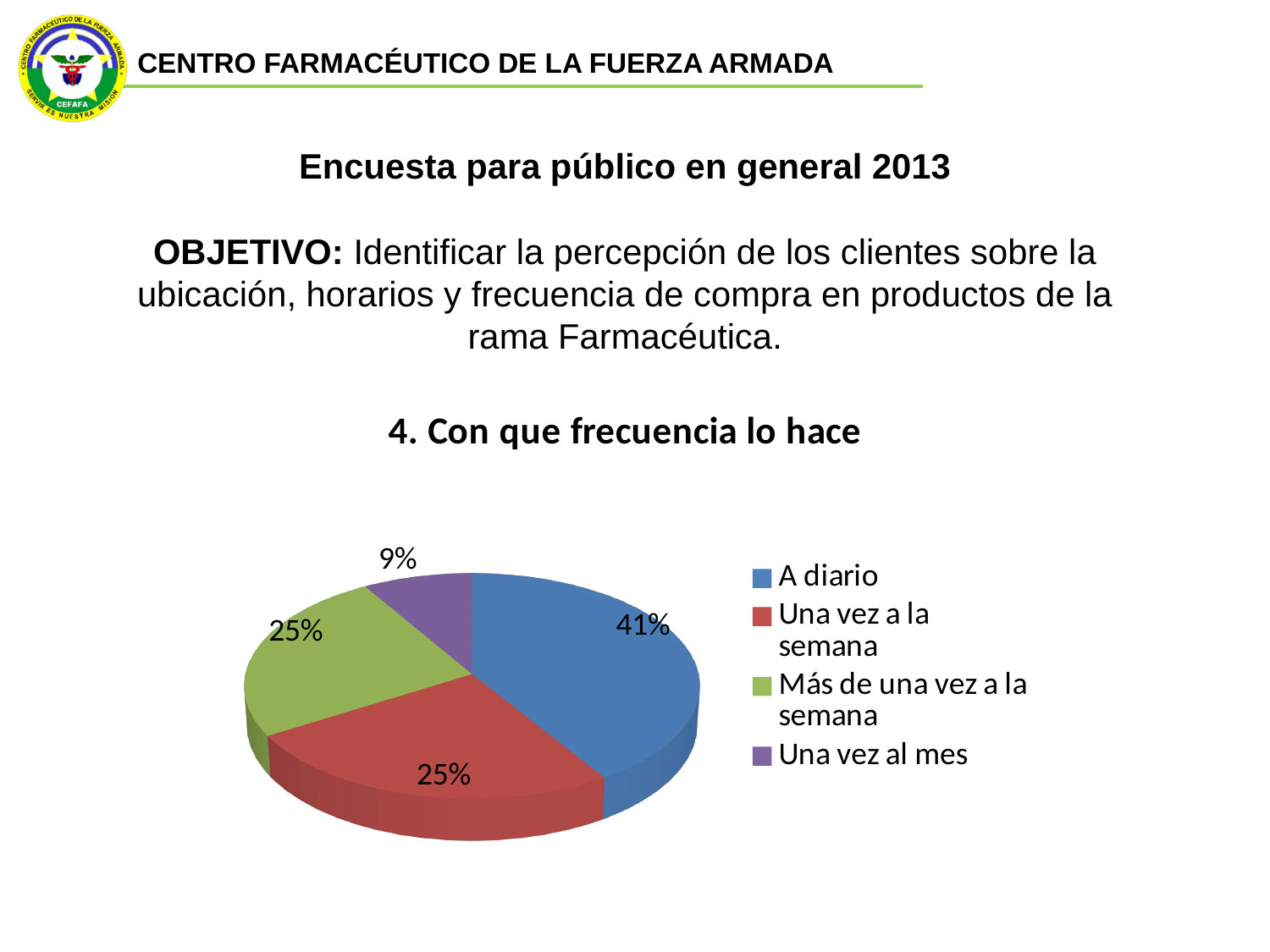
How many categories does the legend list? 4 What is the difference in percentage points between "A diario" and "Una vez al mes"? 32 Which category has the largest share of the pie? A diario What percentage of respondents answered "A diario"? 41% What percentage of respondents answered "Más de una vez a la semana"? 25% What percentage of respondents answered "Una vez a la semana"? 25% What colour is the slice for "Más de una vez a la semana"? green What percentage of respondents answered "Una vez al mes"? 9% Which category has the smallest share of the pie? Una vez al mes What kind of chart is shown on the slide? pie chart What is the title of the chart? 4. Con que frecuencia lo hace Which is larger, the share for "A diario" or the share for "Una vez a la semana"? A diario